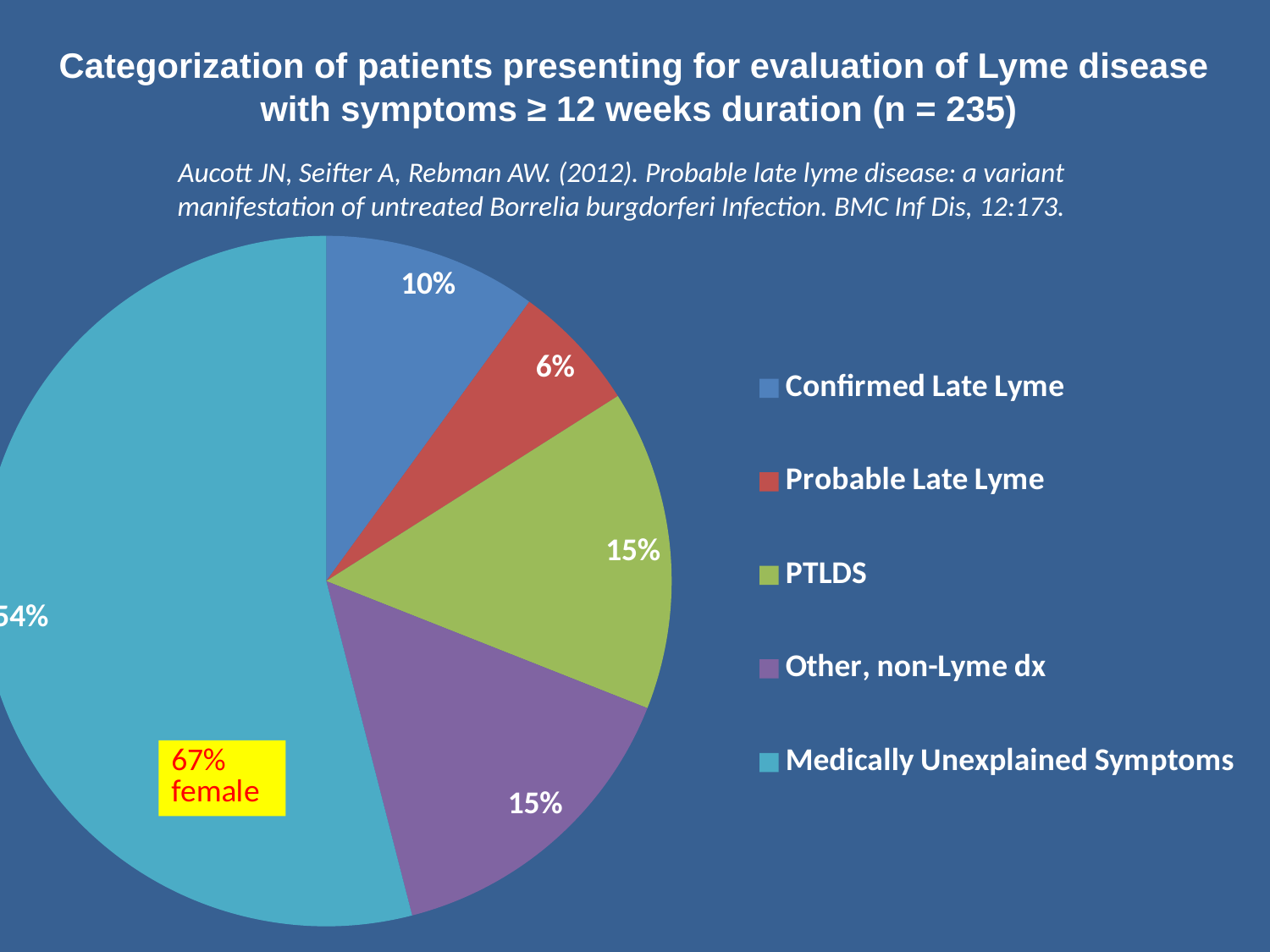
What does the yellow box on the pie chart say? 67% female Which is larger, the share for Confirmed Late Lyme or the share for PTLDS? PTLDS Which category has the largest slice of the pie chart? Medically Unexplained Symptoms What kind of chart is shown on the slide? pie chart What percentage of patients were categorized as Other, non-Lyme dx? 15% How many categories does the pie chart show? 5 What is the difference in percentage points between Confirmed Late Lyme and Probable Late Lyme? 4% Which category has the smallest slice of the pie chart? Probable Late Lyme What percentage of patients were categorized as Probable Late Lyme? 6% What colour is the PTLDS slice in the pie chart? green What percentage of patients were categorized as Confirmed Late Lyme? 10% What percentage of patients were categorized as PTLDS? 15%